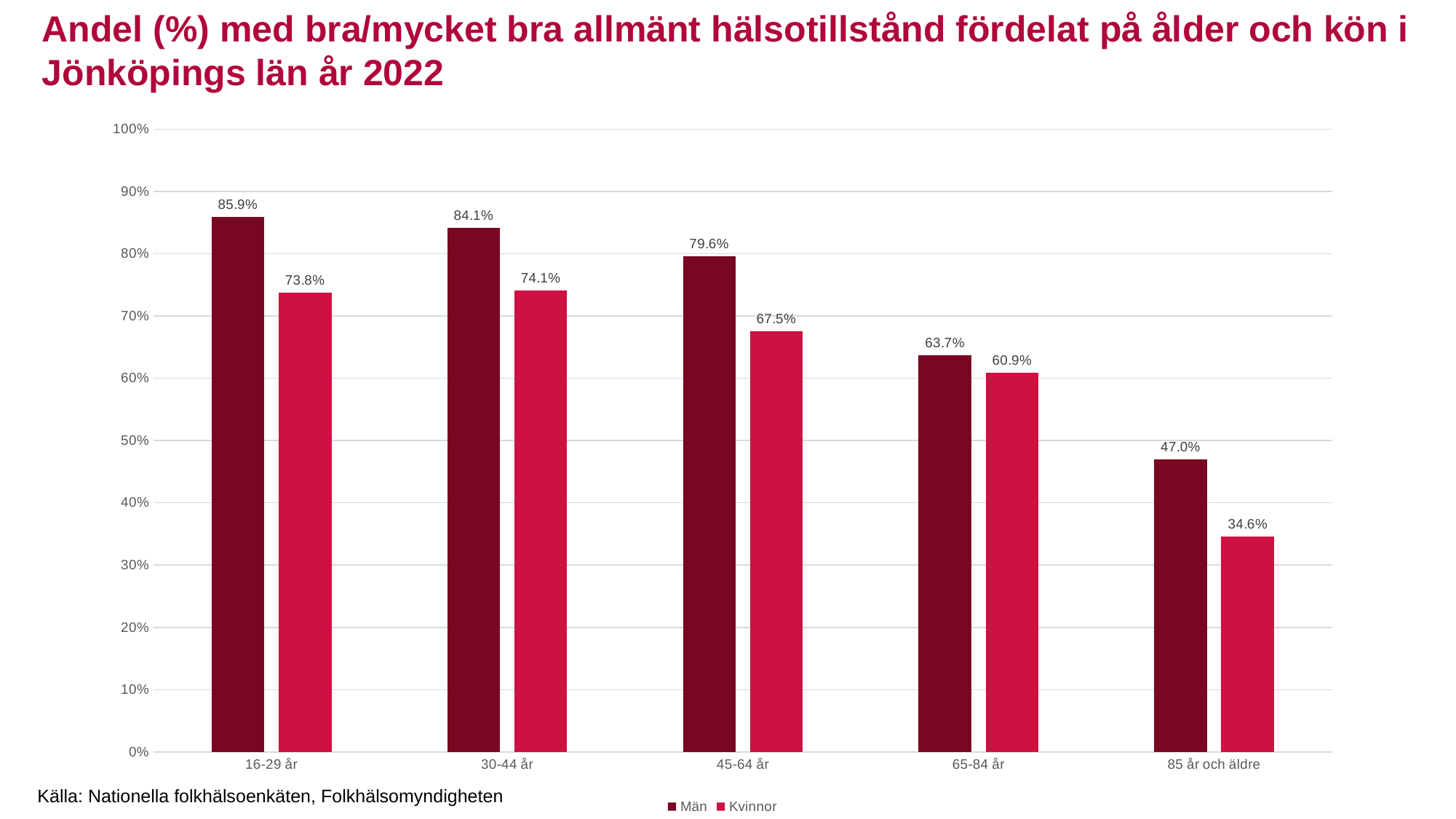
What is the difference between Män and Kvinnor in the 85 år och äldre age group? 12.4 percentage points How many age groups are shown on the x axis? 5 How many series does the legend list? 2 Which age group has the highest value for Män? 16-29 år Which is larger in the 65-84 år age group, Män or Kvinnor? Män What is the difference between Män and Kvinnor in the 16-29 år age group? 12.1 percentage points Which age group has the lowest value for Kvinnor? 85 år och äldre What kind of chart is shown on the slide? Bar chart What is the value for Kvinnor in the 45-64 år age group? 67.5% What is the value for Män in the 16-29 år age group? 85.9% What is the value for Kvinnor in the 85 år och äldre age group? 34.6% Is the value for Kvinnor in the 30-44 år age group greater or less than 70%? greater